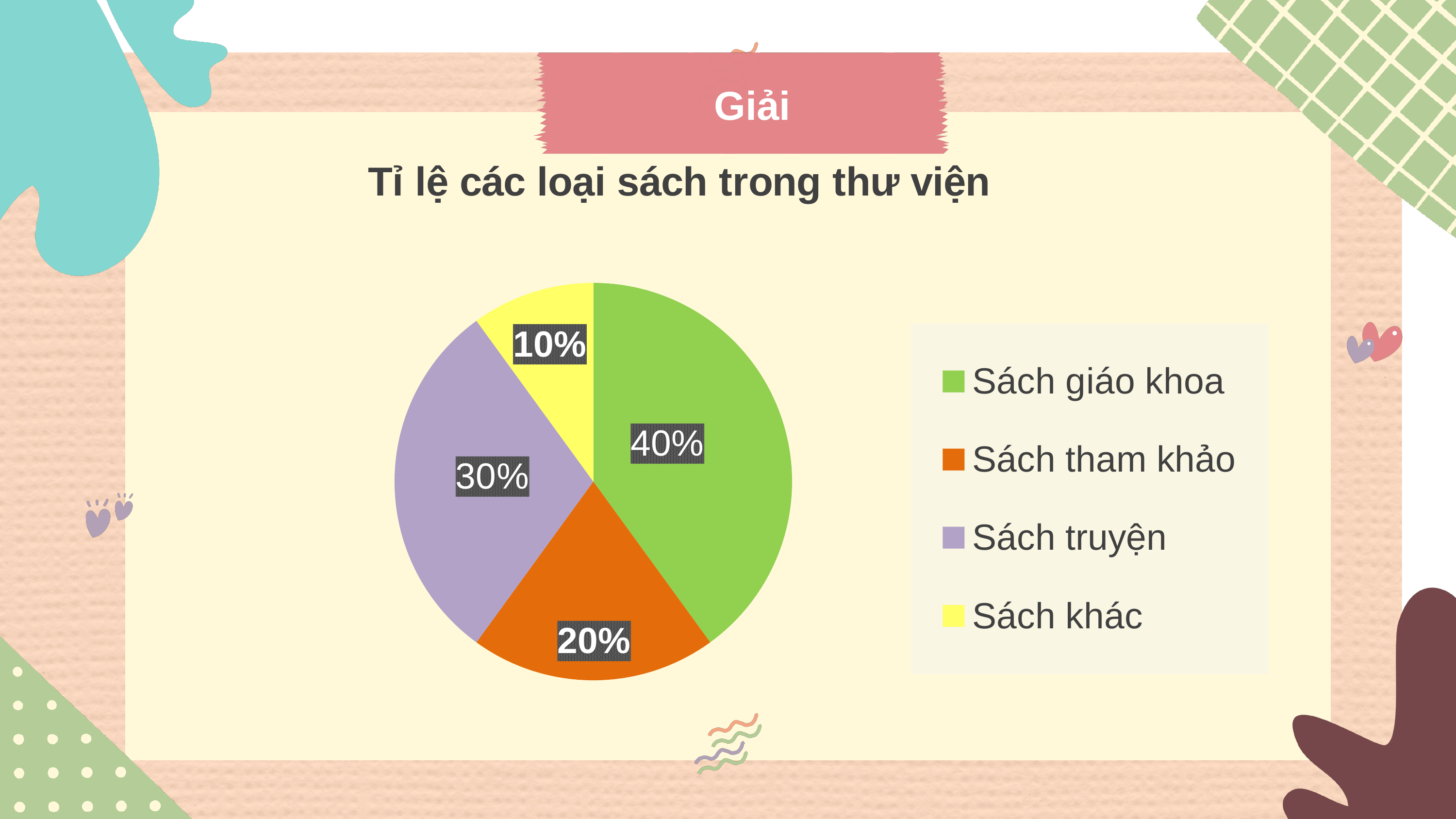
What kind of chart is shown on the slide? pie chart Which is larger, the value for Sách tham khảo or the value for Sách khác? Sách tham khảo Which category has the smallest share of the pie? Sách khác What is the value for Sách truyện? 30% What is the value for Sách tham khảo? 20% What is the value for Sách khác? 10% Which category has the largest share of the pie? Sách giáo khoa How many categories does the pie chart have? 4 What is the difference between the values for Sách giáo khoa and Sách truyện? 10% What colour is the slice for Sách truyện? purple What is the title of the chart? Tỉ lệ các loại sách trong thư viện What is the value for Sách giáo khoa? 40%